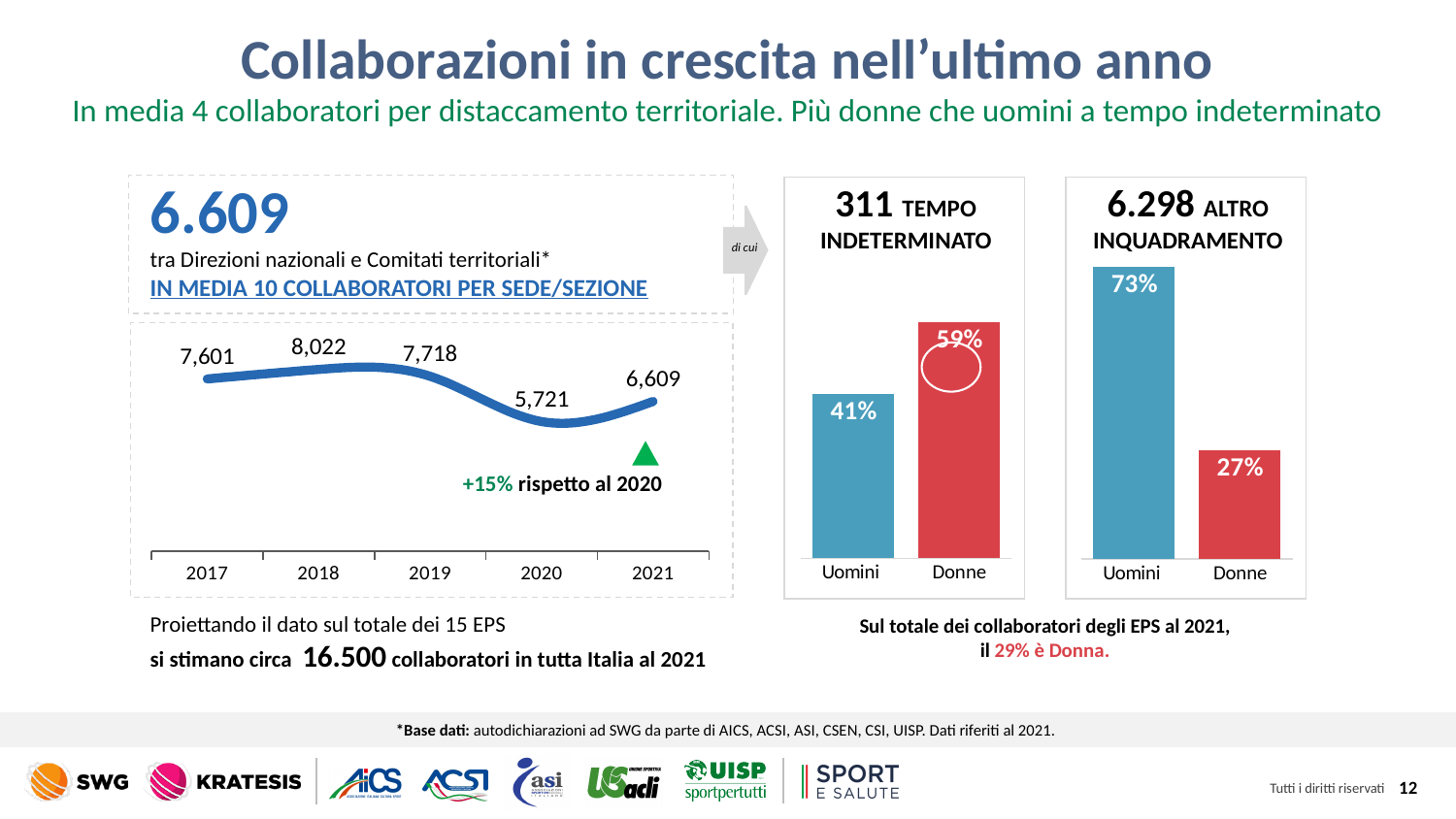
In the line chart on the left, what is the value for 2018? 8,022 What kind of chart is the '311 TEMPO INDETERMINATO' chart? bar chart In the line chart on the left, what is the difference between the 2021 value and the 2020 value? 888 In the line chart on the left, how many years are plotted? 5 In the line chart on the left, does the value rise or fall from 2019 to 2020? fall What kind of chart is the chart on the left showing values from 2017 to 2021? line chart In the '311 TEMPO INDETERMINATO' chart, what is the value for Donne? 59% In the '6.298 ALTRO INQUADRAMENTO' chart, which category is larger, Uomini or Donne? Uomini In the line chart on the left, what is the value for 2020? 5,721 In the line chart on the left, which year has the lowest value? 2020 In the '6.298 ALTRO INQUADRAMENTO' chart, what is the value for Uomini? 73% In the line chart on the left, which year has the highest value? 2018